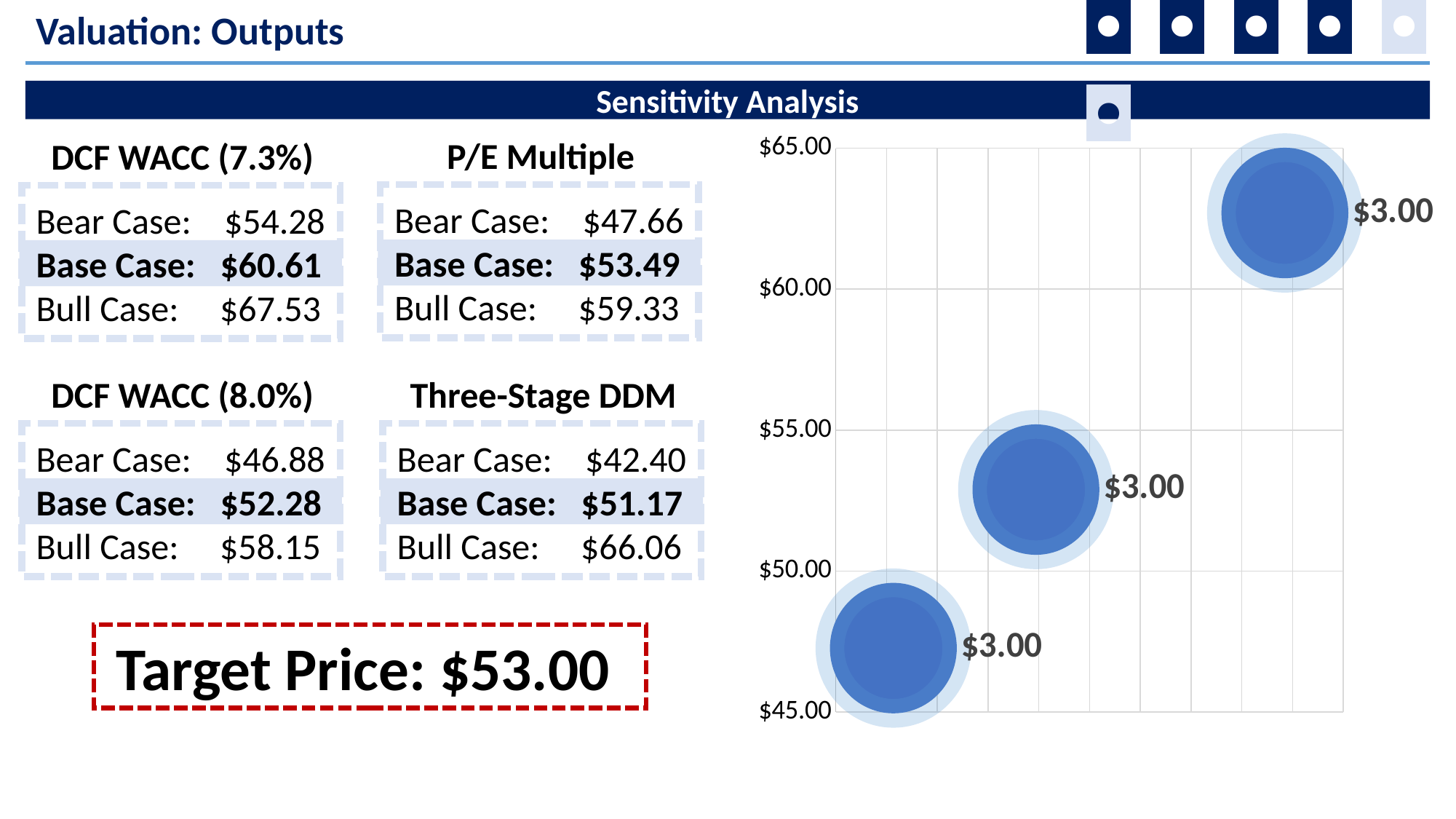
On the Sensitivity Analysis chart, which bubble has the highest value: the leftmost, middle, or rightmost? rightmost What data label is shown next to each bubble on the Sensitivity Analysis chart? $3.00 On the Sensitivity Analysis chart, do the bubbles rise or fall from left to right? rise On the Sensitivity Analysis chart, is the value of the middle bubble greater or less than $50.00? greater What kind of chart is shown under the Sensitivity Analysis heading? bubble chart On the Sensitivity Analysis chart, which bubble has the lowest value: the leftmost, middle, or rightmost? leftmost What is the lowest value shown on the vertical axis of the Sensitivity Analysis chart? $45.00 What is the highest value shown on the vertical axis of the Sensitivity Analysis chart? $65.00 How many bubbles are plotted on the Sensitivity Analysis chart? 3 On the Sensitivity Analysis chart, is the value of the rightmost (top) bubble greater or less than $60.00? greater On the Sensitivity Analysis chart, is the value of the middle bubble greater or less than $55.00? less